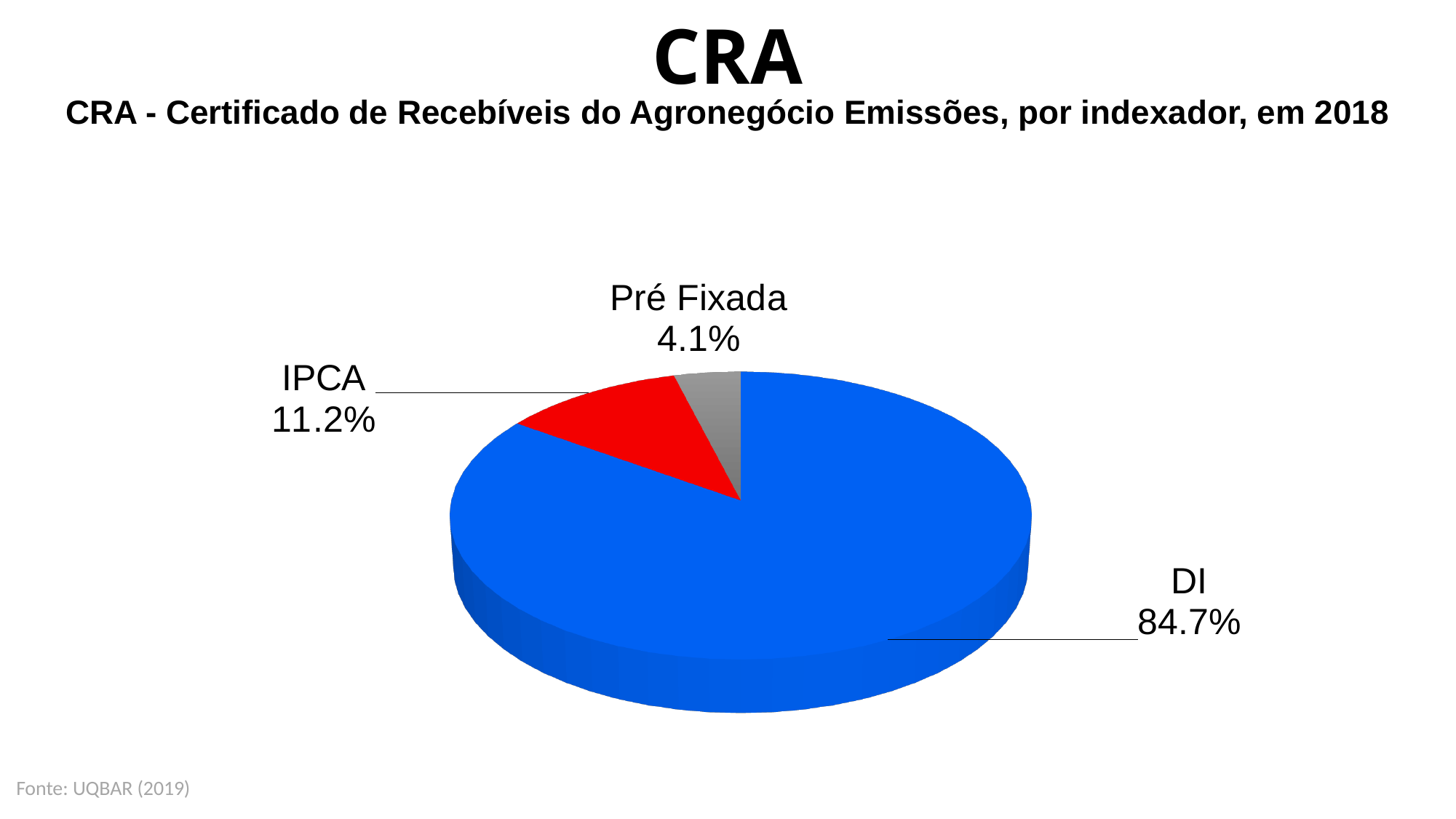
Which indexer has the largest slice of the pie? DI What share of CRA emissions in 2018 is indexed to DI? 84.7% How many slices does the pie chart have? 3 What source is cited for the chart data? UQBAR (2019) What is the difference in percentage points between the DI and IPCA slices? 73.5 Which slice is larger, IPCA or Pré Fixada? IPCA What is the difference in percentage points between the IPCA and Pré Fixada slices? 7.1 What share of CRA emissions in 2018 is indexed to IPCA? 11.2% What share of CRA emissions in 2018 is Pré Fixada? 4.1% What colour is the DI slice of the pie? Blue Which indexer has the smallest slice of the pie? Pré Fixada What kind of chart is shown on the slide? Pie chart